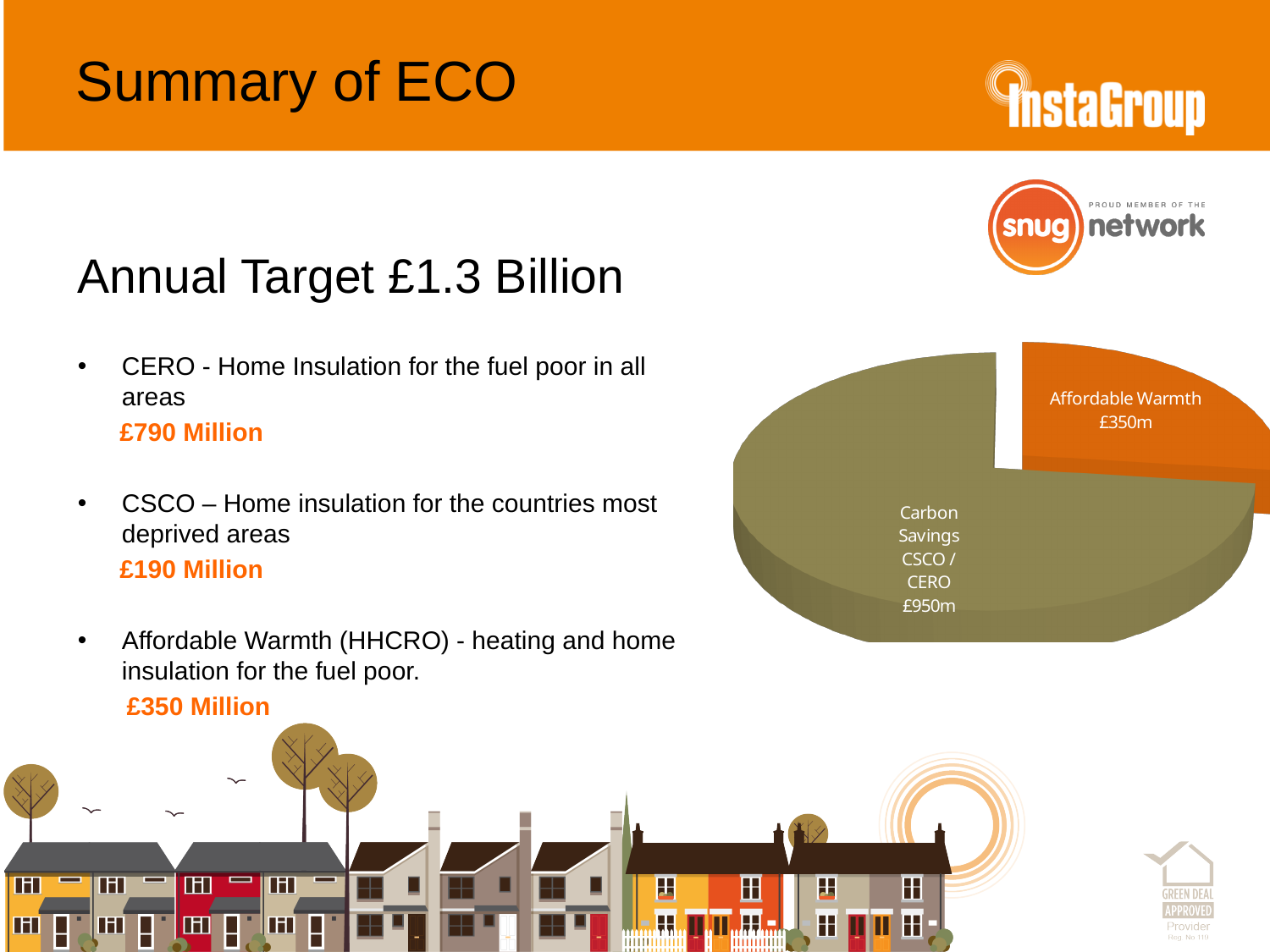
What is the value of the Carbon Savings CSCO / CERO slice in the pie chart? £950m What is the value of the Affordable Warmth slice in the pie chart? £350m What is the difference between the Carbon Savings CSCO / CERO slice and the Affordable Warmth slice? £600m What is the total of the two slices in the pie chart? £1,300m What colour is the Affordable Warmth slice in the pie chart? orange How many slices does the pie chart have? 2 What kind of chart is shown on the slide? pie chart Which slice of the pie chart is the largest? Carbon Savings CSCO / CERO Which slice of the pie chart is the smallest? Affordable Warmth Which is larger in the pie chart, Affordable Warmth or Carbon Savings CSCO / CERO? Carbon Savings CSCO / CERO